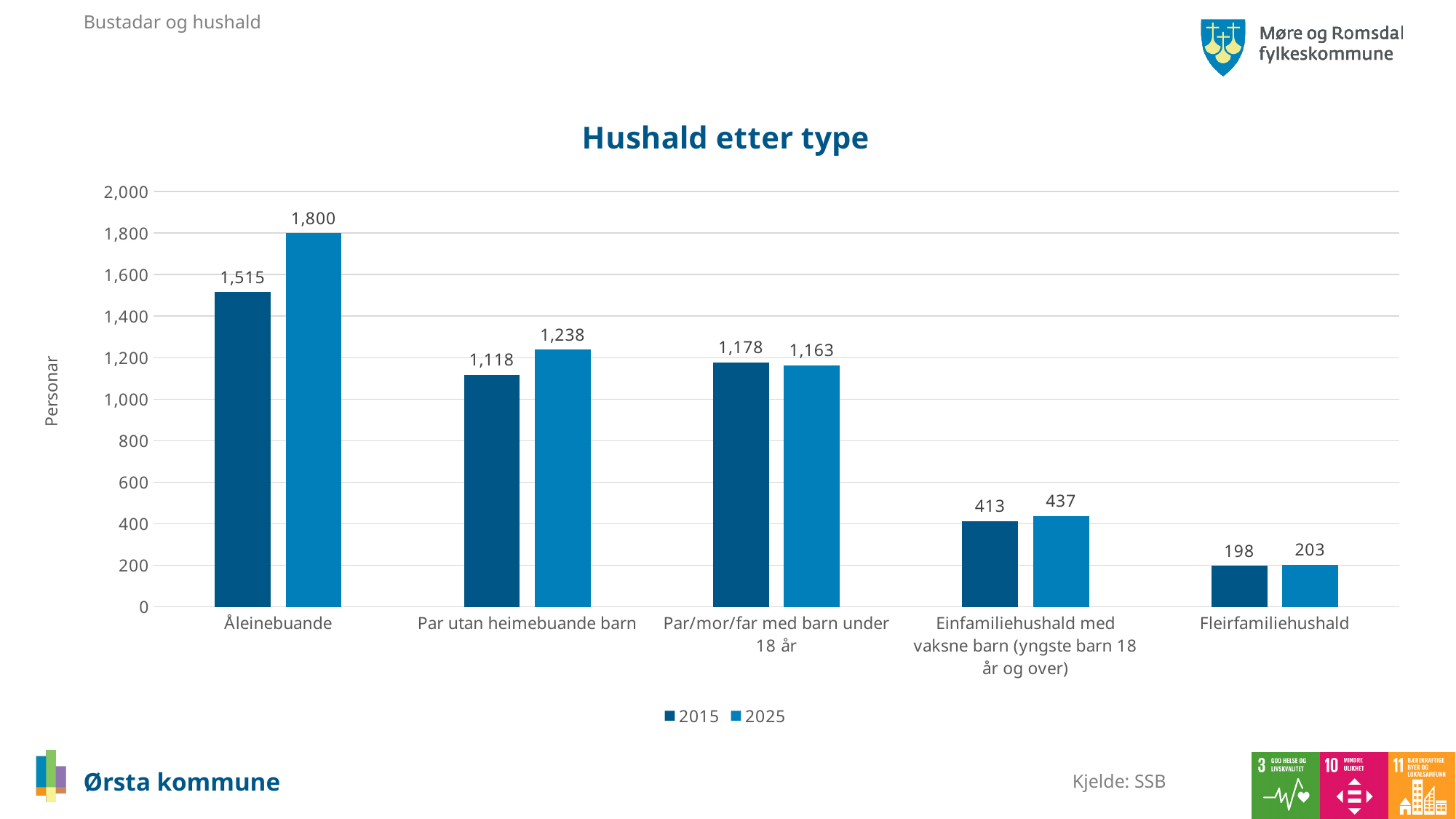
What is the difference between the 2015 and 2025 values for Par/mor/far med barn under 18 år? 15 Which category has the lowest 2025 value? Fleirfamiliehushald What is the 2025 value for Fleirfamiliehushald? 203 What kind of chart is shown on the slide? Bar chart How many series does the legend list? 2 What is the difference between the 2025 and 2015 values for Åleinebuande? 285 How many household type categories are shown on the x axis? 5 What is the 2015 value for Par utan heimebuande barn? 1,118 Which category has the highest 2015 value? Åleinebuande What is the title of the chart? Hushald etter type What is the 2025 value for Åleinebuande? 1,800 Which is larger for Einfamiliehushald med vaksne barn (yngste barn 18 år og over): the 2015 value or the 2025 value? 2025